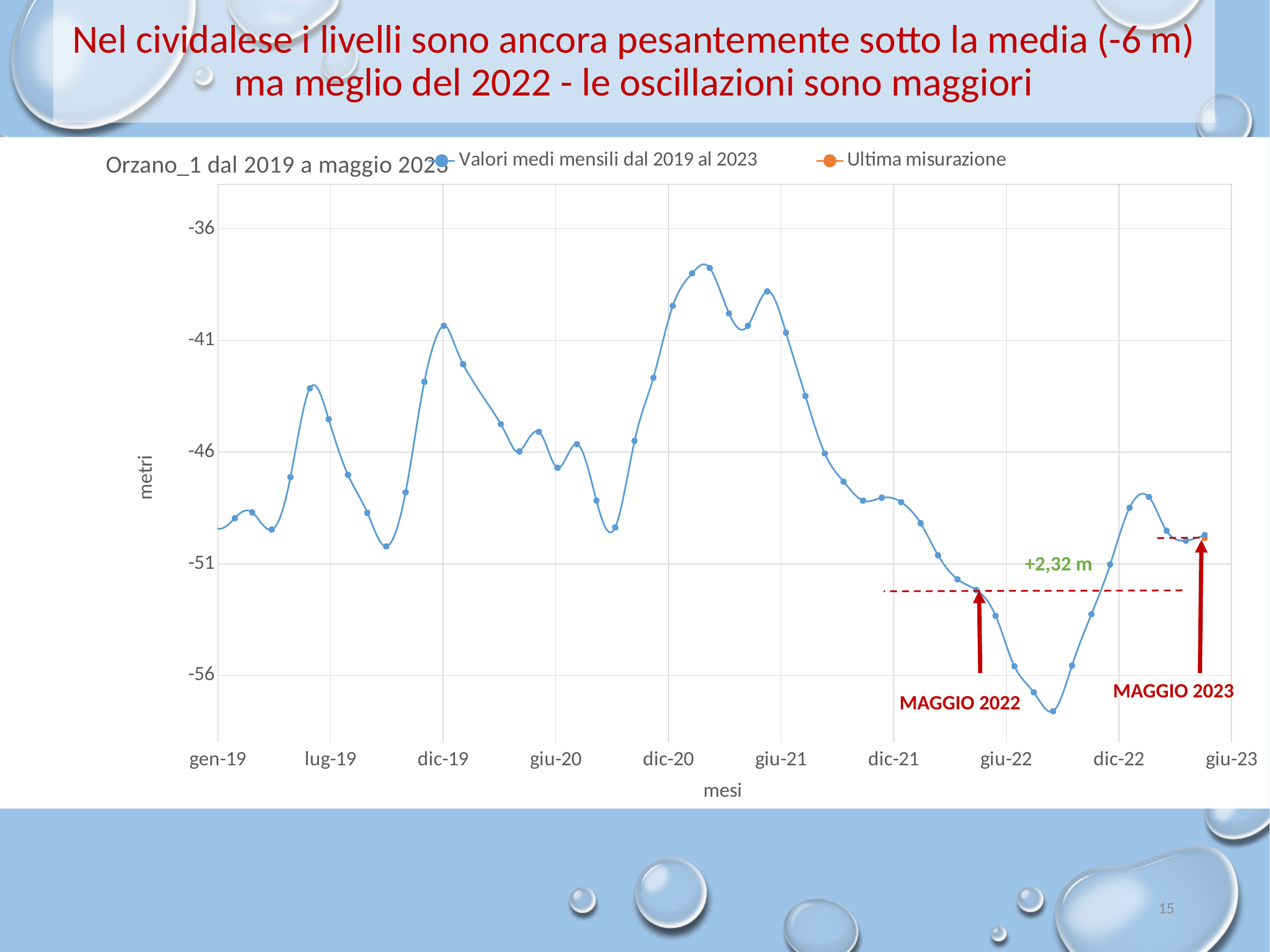
How many series does the chart legend list? 2 Do the values rise or fall between dic-21 and giu-22? fall Is the value for lug-19 greater or less than -46? greater What is the title of the chart? Orzano_1 dal 2019 a maggio 2023 Is the value for gen-19 greater or less than -46? less Is the value for giu-22 greater or less than -51? less What kind of chart is shown on the slide? line chart Which is higher, the value at dic-20 or the value at dic-21? dic-20 What is the label of the vertical axis? metri By how much is the May 2023 level higher than the May 2022 level, according to the annotation on the chart? +2,32 m In which year does the monthly series reach its lowest value? 2022